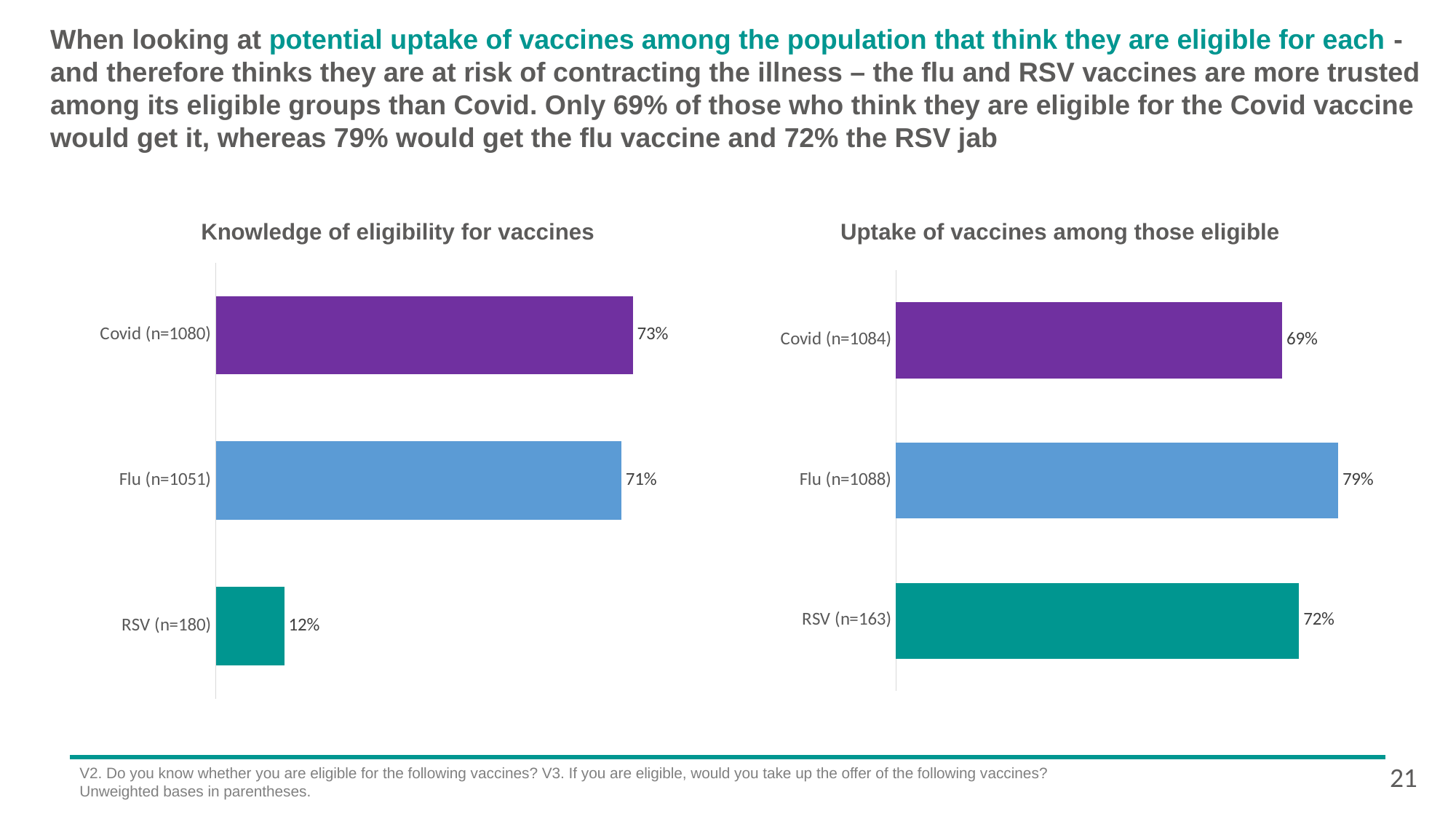
In the 'Uptake of vaccines among those eligible' chart, what is the value for Flu (n=1088)? 79% In the 'Knowledge of eligibility for vaccines' chart, what is the difference between the values for Covid (n=1080) and RSV (n=180)? 61 percentage points In the 'Knowledge of eligibility for vaccines' chart, what is the value for Covid (n=1080)? 73% In the 'Knowledge of eligibility for vaccines' chart, which category has the highest value? Covid (n=1080) In the 'Knowledge of eligibility for vaccines' chart, what is the value for RSV (n=180)? 12% In the 'Uptake of vaccines among those eligible' chart, what is the value for RSV (n=163)? 72% In the 'Uptake of vaccines among those eligible' chart, which category has the lowest value? Covid (n=1084) In the 'Knowledge of eligibility for vaccines' chart, which category has the lowest value? RSV (n=180) What kind of chart is the 'Knowledge of eligibility for vaccines' chart? Bar chart In the 'Uptake of vaccines among those eligible' chart, which is larger, the value for RSV (n=163) or Covid (n=1084)? RSV (n=163) In the 'Uptake of vaccines among those eligible' chart, what is the difference between the values for Flu (n=1088) and Covid (n=1084)? 10 percentage points In the 'Uptake of vaccines among those eligible' chart, which category has the highest value? Flu (n=1088)